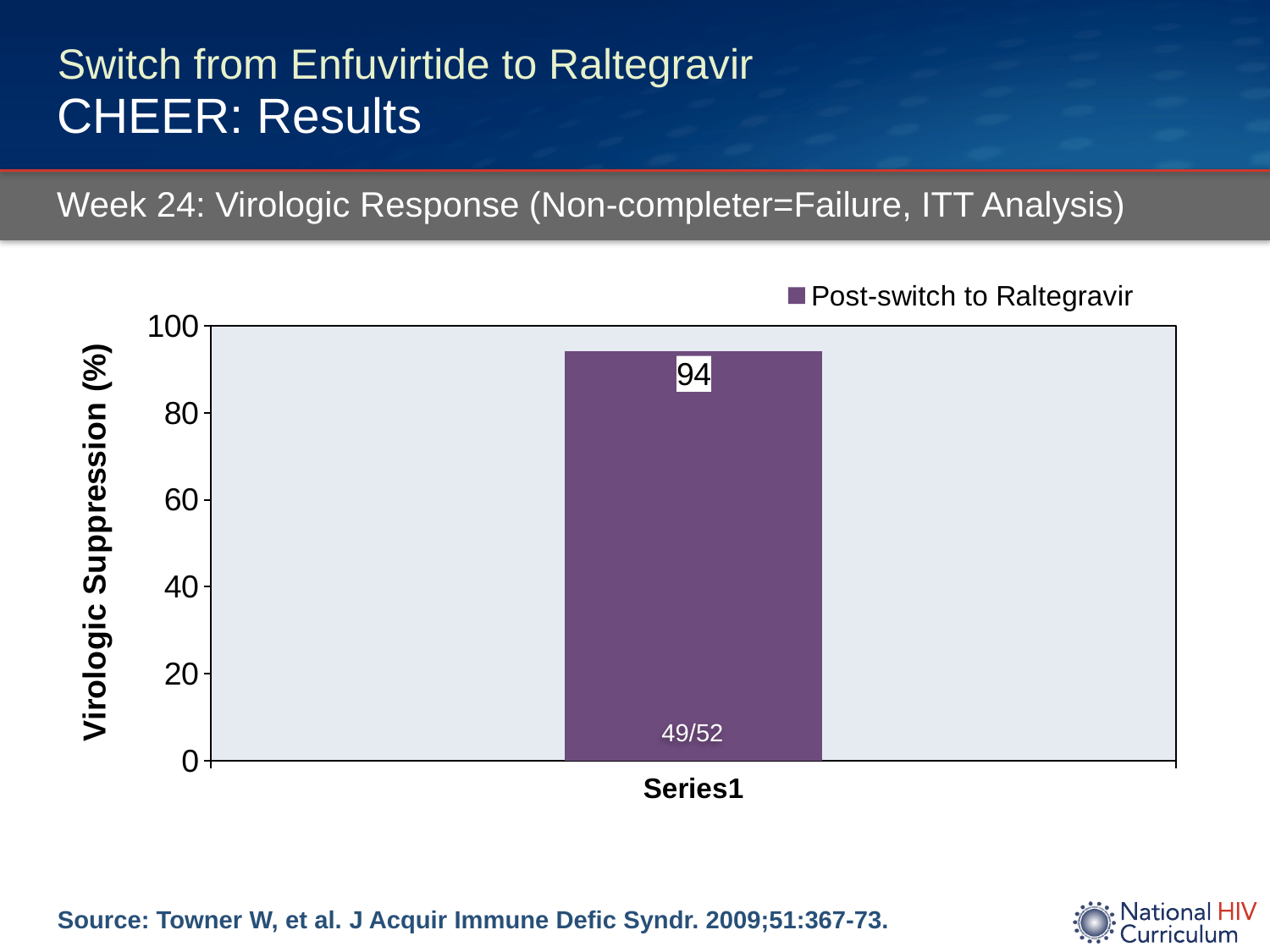
What is the maximum value shown on the y axis? 100 Is the value for Post-switch to Raltegravir greater or less than 100? less What is the category label shown on the x axis? Series1 What is the label on the y axis of the chart? Virologic Suppression (%) Is the value for Post-switch to Raltegravir greater or less than 80? greater What series name does the legend show? Post-switch to Raltegravir What is the virologic suppression value shown for the Post-switch to Raltegravir bar? 94 What fraction is printed at the base of the Post-switch to Raltegravir bar? 49/52 How many series does the legend list? 1 How many bars are plotted in the chart? 1 What kind of chart is shown on the slide? bar chart